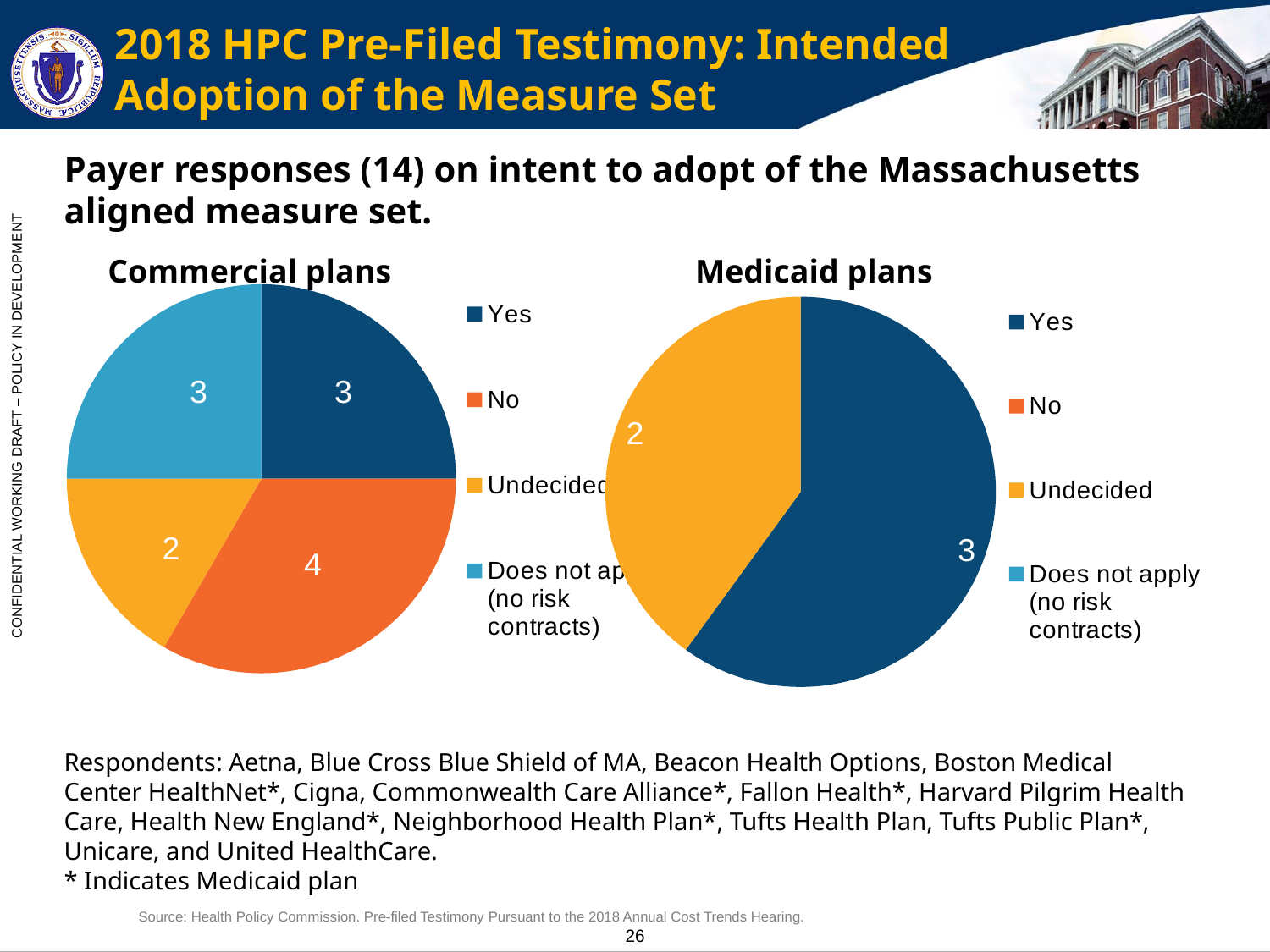
In the Commercial plans chart, how many payers responded "Undecided"? 2 In the Medicaid plans chart, what is the difference between the "Yes" and "Undecided" counts? 1 In the Commercial plans chart, which response has the smallest slice? Undecided In the Commercial plans chart, what is the difference between the number of "No" responses and the number of "Undecided" responses? 2 In the Commercial plans chart, which response has the largest slice? No In the Commercial plans chart, how many payers responded "No"? 4 How many entries does the legend of the Medicaid plans chart list? 4 In the Medicaid plans chart, how many payers responded "Undecided"? 2 In the Medicaid plans chart, how many payers responded "Yes"? 3 In the Commercial plans chart, is the "No" slice larger or smaller than the "Yes" slice? larger In the Medicaid plans chart, which response has the larger slice? Yes What type of chart is used for the Commercial plans and Medicaid plans? Pie chart